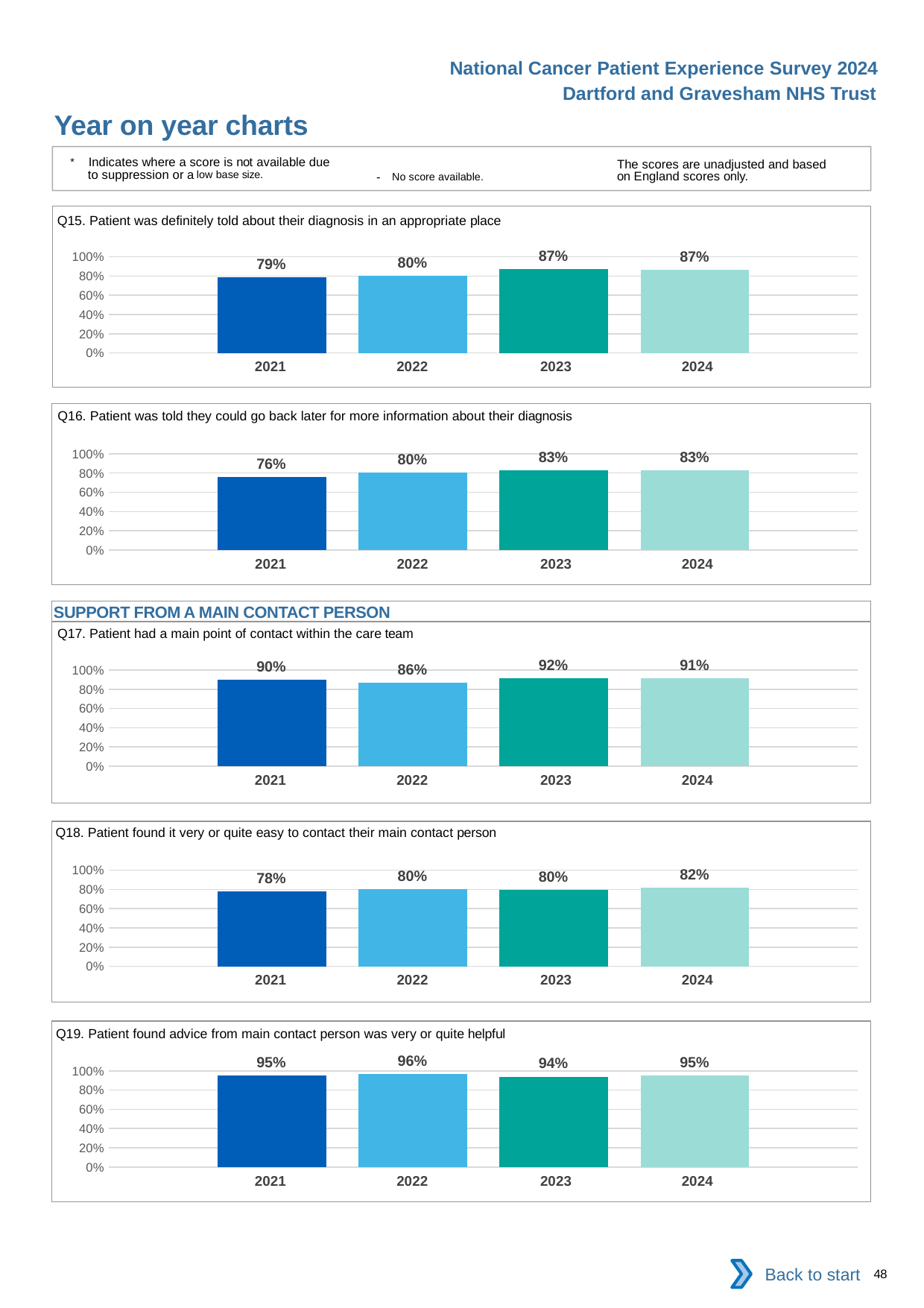
What is the section heading shown above the Q17 chart? SUPPORT FROM A MAIN CONTACT PERSON In the Q19 chart (patient found advice from main contact person was very or quite helpful), which year has the highest value? 2022 In the Q19 chart (patient found advice from main contact person was very or quite helpful), what is the value for 2023? 94% In the Q17 chart (patient had a main point of contact within the care team), which year has the lowest value? 2022 In the Q16 chart (patient was told they could go back later for more information about their diagnosis), do the values rise or fall from 2021 to 2023? rise In the Q18 chart (patient found it very or quite easy to contact their main contact person), what is the difference between the 2024 and 2021 values? 4 percentage points In the Q17 chart (patient had a main point of contact within the care team), which year has the highest value? 2023 In the Q15 chart (patient was definitely told about their diagnosis in an appropriate place), how many years are plotted? 4 What kind of chart is the Q18 chart (patient found it very or quite easy to contact their main contact person)? bar chart In the Q16 chart (patient was told they could go back later for more information about their diagnosis), is the value for 2022 larger or smaller than the value for 2021? larger In the Q15 chart (patient was definitely told about their diagnosis in an appropriate place), what is the value for 2021? 79% In the Q16 chart (patient was told they could go back later for more information about their diagnosis), what is the value for 2024? 83%